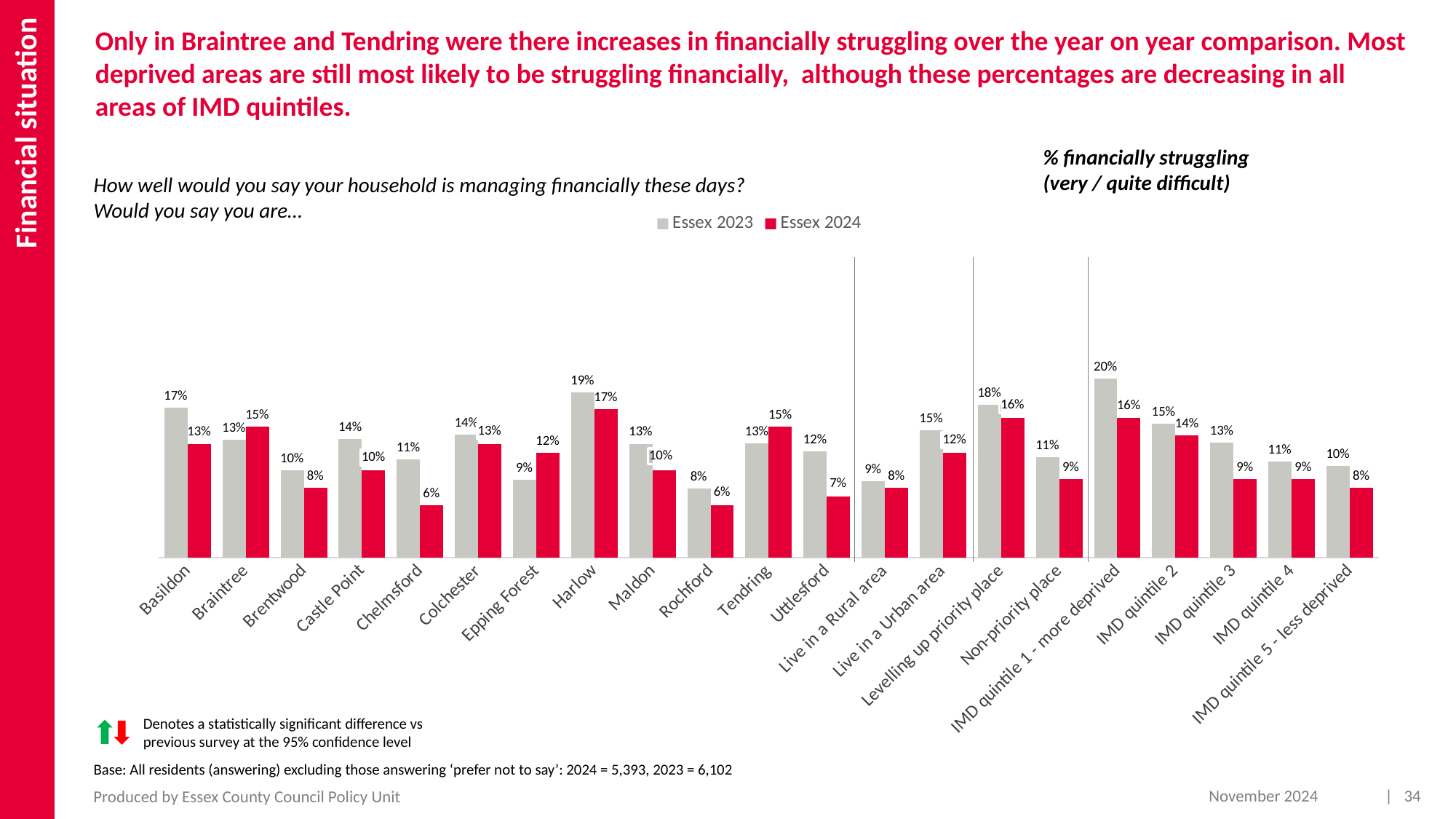
Which category has the highest Essex 2024 value? Harlow Which category has the highest Essex 2023 value? IMD quintile 1 - more deprived What is the Essex 2024 value for Chelmsford? 6% What kind of chart is shown on the slide? Bar chart Which colour represents Essex 2024 in the chart? Red What is the difference between the Essex 2023 and Essex 2024 values for Uttlesford? 5% How many series does the legend list? 2 Which category has the lowest Essex 2023 value? Rochford What is the Essex 2024 value for Harlow? 17% What is the Essex 2023 value for IMD quintile 1 - more deprived? 20% How many categories are shown on the x axis of the chart? 21 Which is larger for Braintree, the Essex 2023 value or the Essex 2024 value? Essex 2024